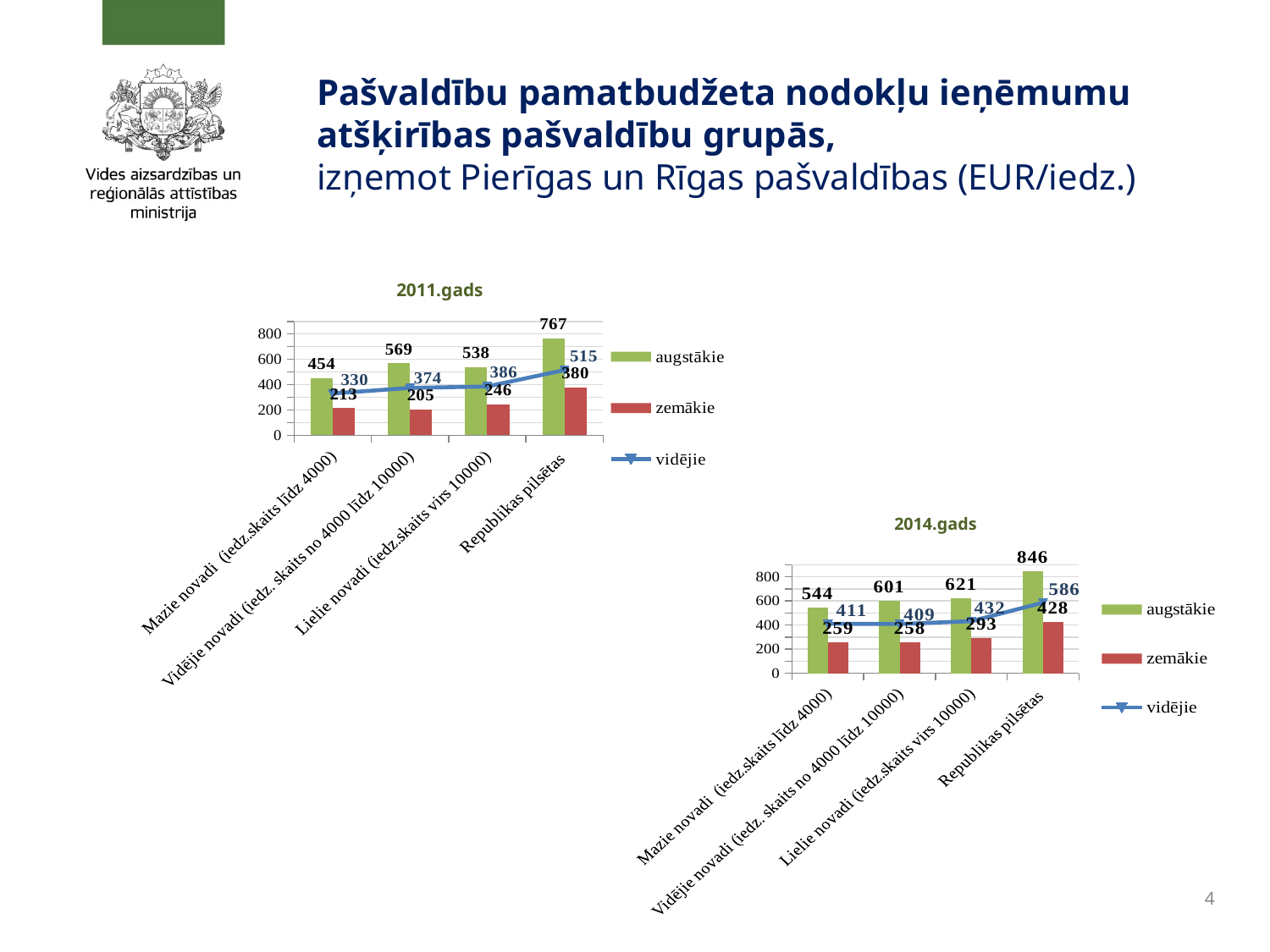
In the 2014.gads chart, what is the difference between the augstākie and zemākie values for Republikas pilsētas? 418 In the 2014.gads chart, which series is drawn as a line? vidējie In the 2011.gads chart, what is the vidējie value for Mazie novadi (iedz.skaits līdz 4000)? 330 How many series does the legend of the 2014.gads chart list? 3 In the 2014.gads chart, which category has the highest augstākie value? Republikas pilsētas In the 2011.gads chart, what is the augstākie value for Republikas pilsētas? 767 In the 2014.gads chart, is the vidējie value for Republikas pilsētas greater or less than 400? greater In the 2011.gads chart, which is larger: the augstākie value for Vidējie novadi (iedz. skaits no 4000 līdz 10000) or for Lielie novadi (iedz.skaits virs 10000)? Vidējie novadi (iedz. skaits no 4000 līdz 10000) In the 2014.gads chart, what is the zemākie value for Lielie novadi (iedz.skaits virs 10000)? 293 What kind of chart is the 2011.gads chart? Combined bar and line chart How many categories are shown on the x axis of the 2011.gads chart? 4 In the 2011.gads chart, which category has the lowest zemākie value? Vidējie novadi (iedz. skaits no 4000 līdz 10000)